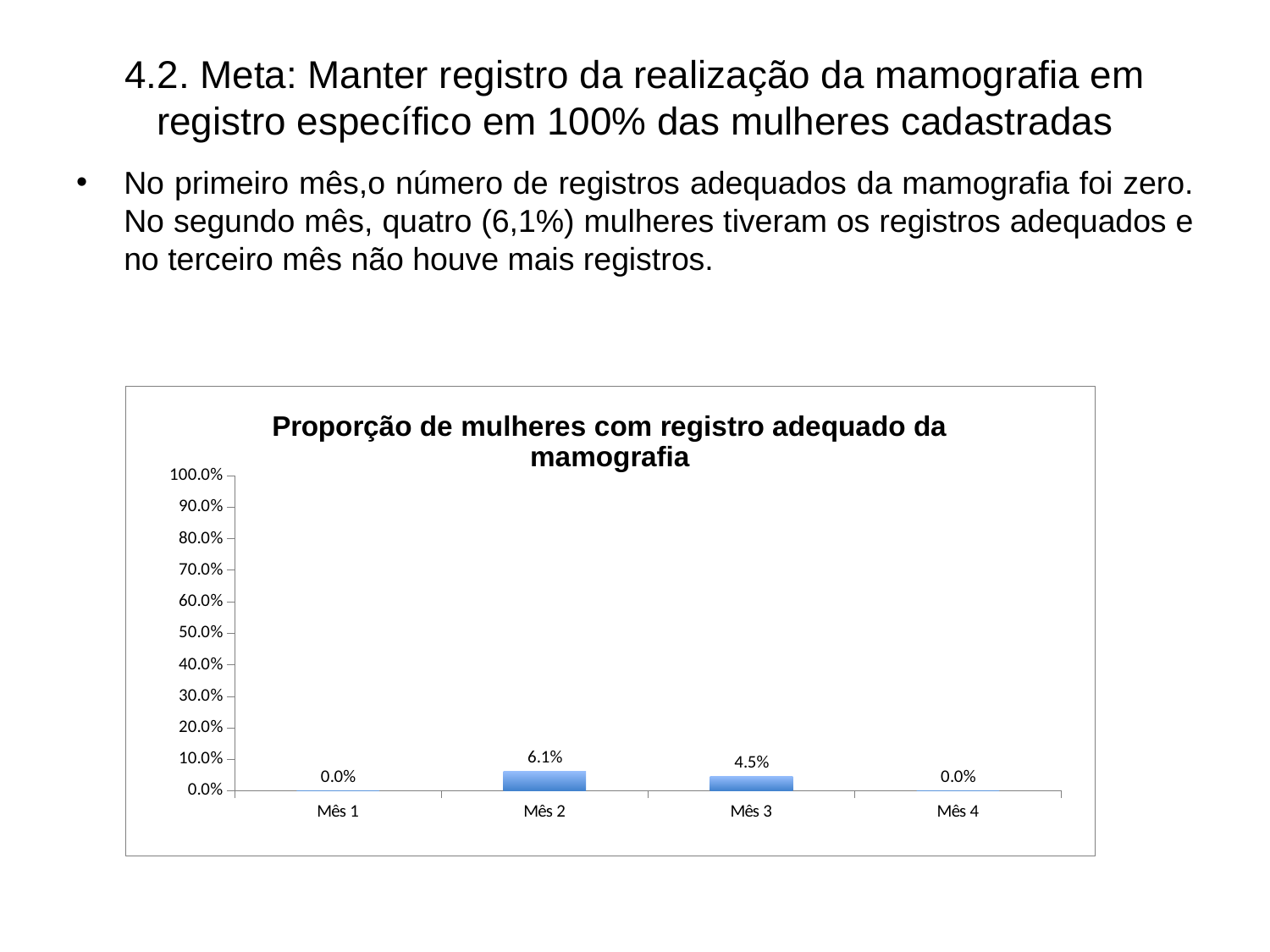
How many months are shown on the x axis? 4 Is the value for Mês 2 greater or less than 10.0%? less What kind of chart is shown? bar chart What is the title of the chart? Proporção de mulheres com registro adequado da mamografia What is the value for Mês 1? 0.0% What is the value for Mês 4? 0.0% What is the difference between the values for Mês 2 and Mês 3? 1.6% Which month has the highest value? Mês 2 Which is larger, the value for Mês 2 or the value for Mês 3? Mês 2 What is the value for Mês 2? 6.1% What is the value for Mês 3? 4.5% What is the maximum value shown on the y axis? 100.0%